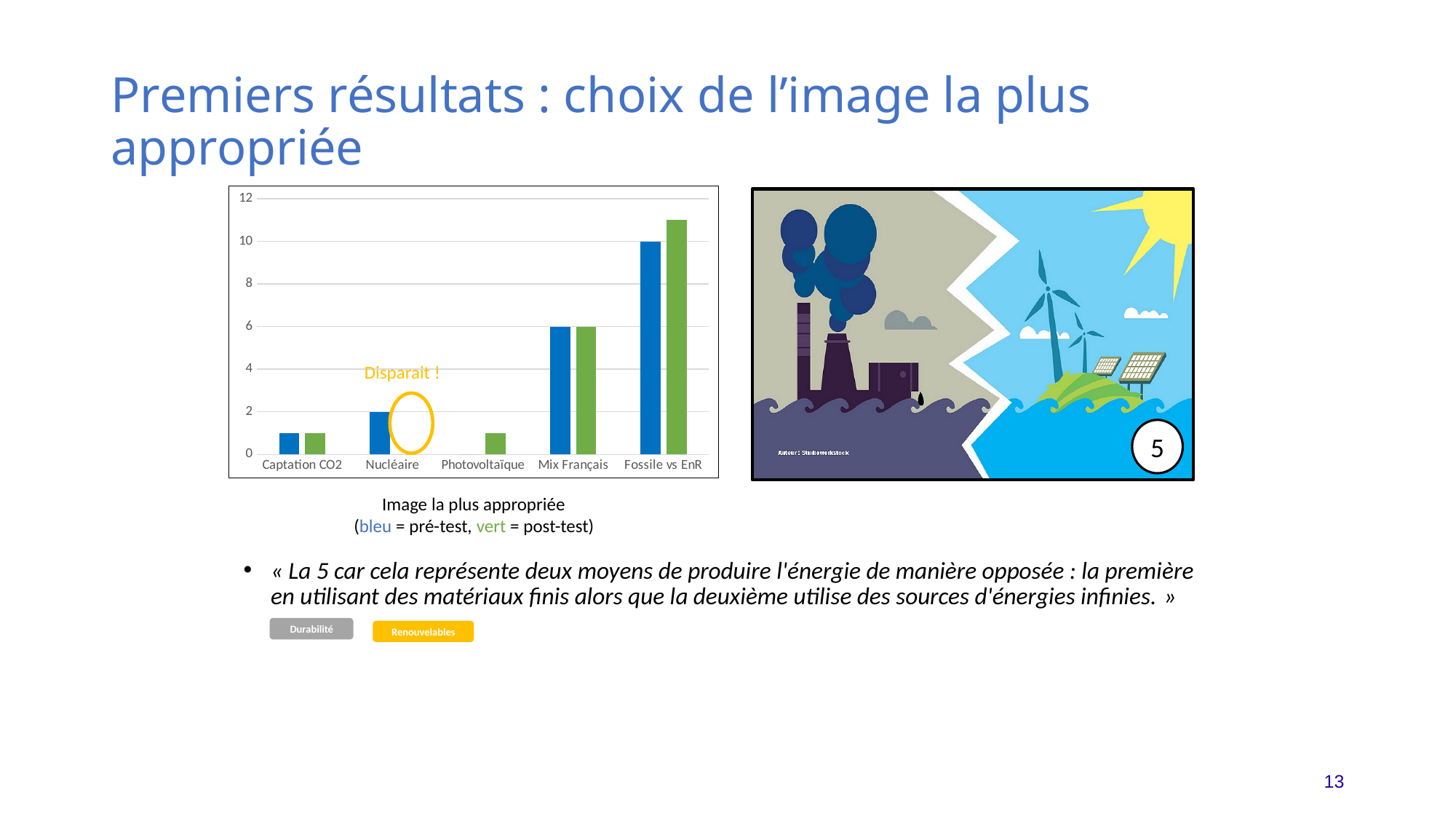
Is the post-test (green) value for Fossile vs EnR greater or less than 10? greater What is the pré-test (blue) value for Nucléaire? 2 What is the post-test (green) value for Mix Français? 6 Which category has the highest bars in the chart? Fossile vs EnR Is the pré-test (blue) value for Captation CO2 greater or less than 2? less Which category has no post-test (green) bar, marked with the annotation 'Disparait !'? Nucléaire What is the pré-test (blue) value for Mix Français? 6 What is the pré-test (blue) value for Fossile vs EnR? 10 According to the caption under the chart, how many series does the bar chart show? 2 How many categories are shown on the x axis of the bar chart? 5 What is the difference between the pré-test values for Fossile vs EnR and Mix Français? 4 What kind of chart is shown on the left of the slide? bar chart